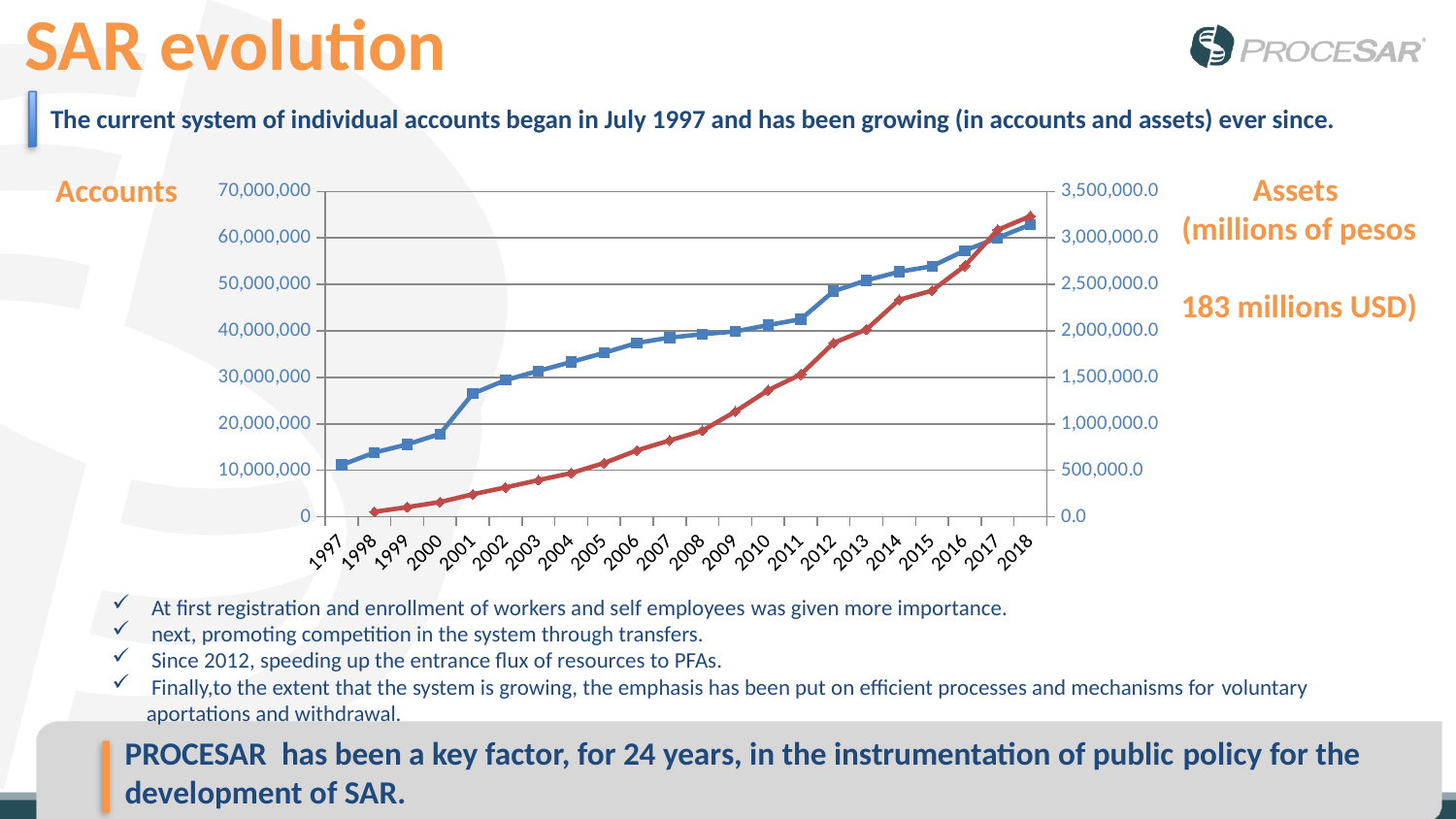
Is the Assets value for 2018 greater or less than 3,000,000.0? greater Is the Accounts value for 2001 greater or less than 30,000,000? less Is the Assets value for 2008 greater or less than 1,000,000.0? less What kind of chart is shown on the slide? Line chart What is the first year shown on the x axis of the chart? 1997 In which year is the Accounts value lowest? 1997 How many data series are plotted on the chart? 2 Do the Accounts values rise or fall from 1997 to 2018? Rise Which is larger, the Accounts value for 2012 or the Accounts value for 2005? 2012 In which year is the Accounts value highest? 2018 How many years are shown along the x axis of the chart? 22